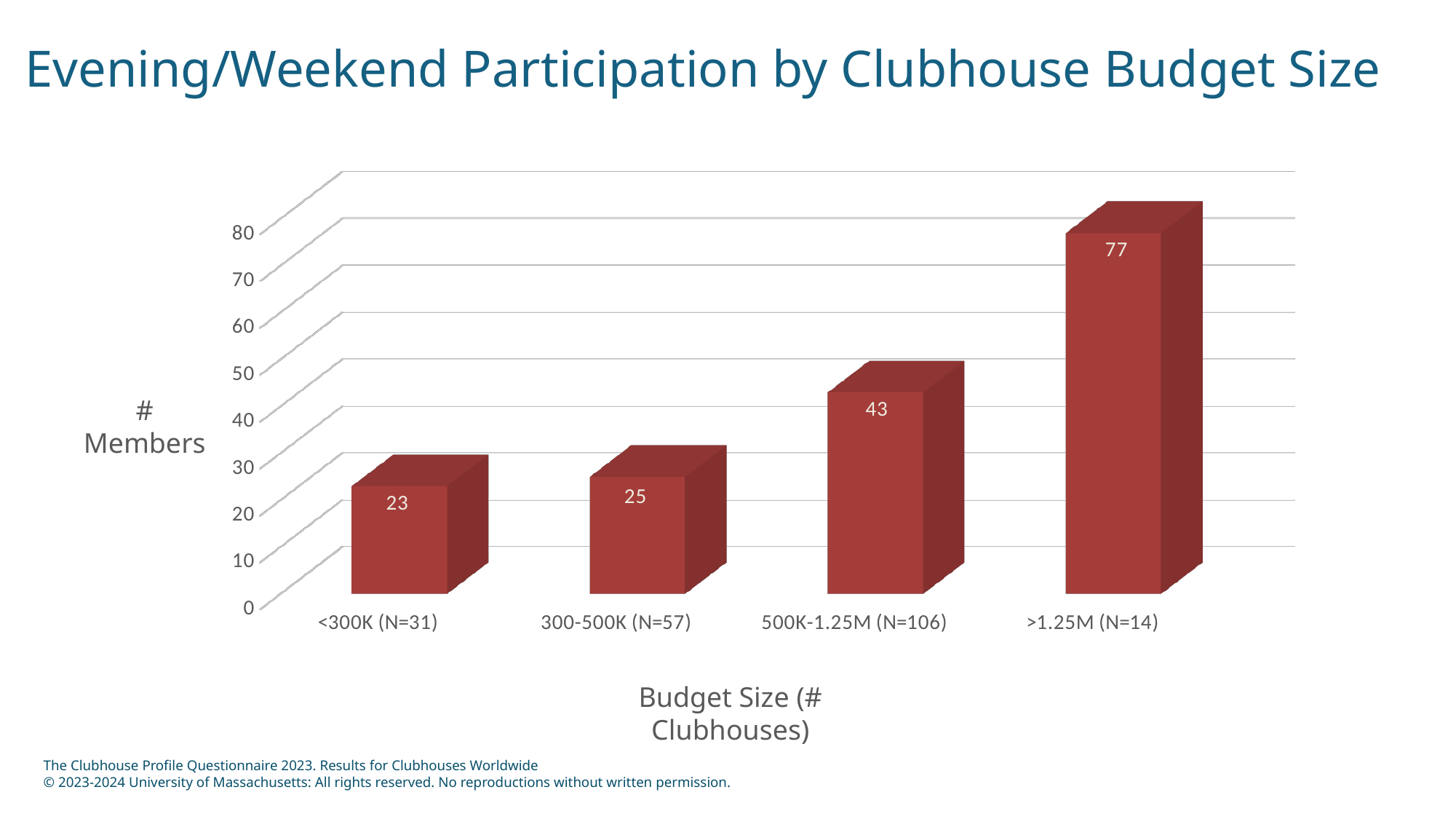
Do the number of members rise or fall as budget size increases along the x axis? Rise What is the number of members for the <300K (N=31) budget size? 23 What is the difference in number of members between the >1.25M (N=14) and 500K-1.25M (N=106) budget sizes? 34 Which budget size has the highest number of members? >1.25M (N=14) Which budget size has the lowest number of members? <300K (N=31) Which has more members, the 300-500K (N=57) or the 500K-1.25M (N=106) budget size? 500K-1.25M (N=106) What is the number of members for the >1.25M (N=14) budget size? 77 What is the number of members for the 300-500K (N=57) budget size? 25 What is the label of the vertical axis? # Members What kind of chart is shown on the slide? Bar chart How many budget size categories are shown in the chart? 4 What is the number of members for the 500K-1.25M (N=106) budget size? 43